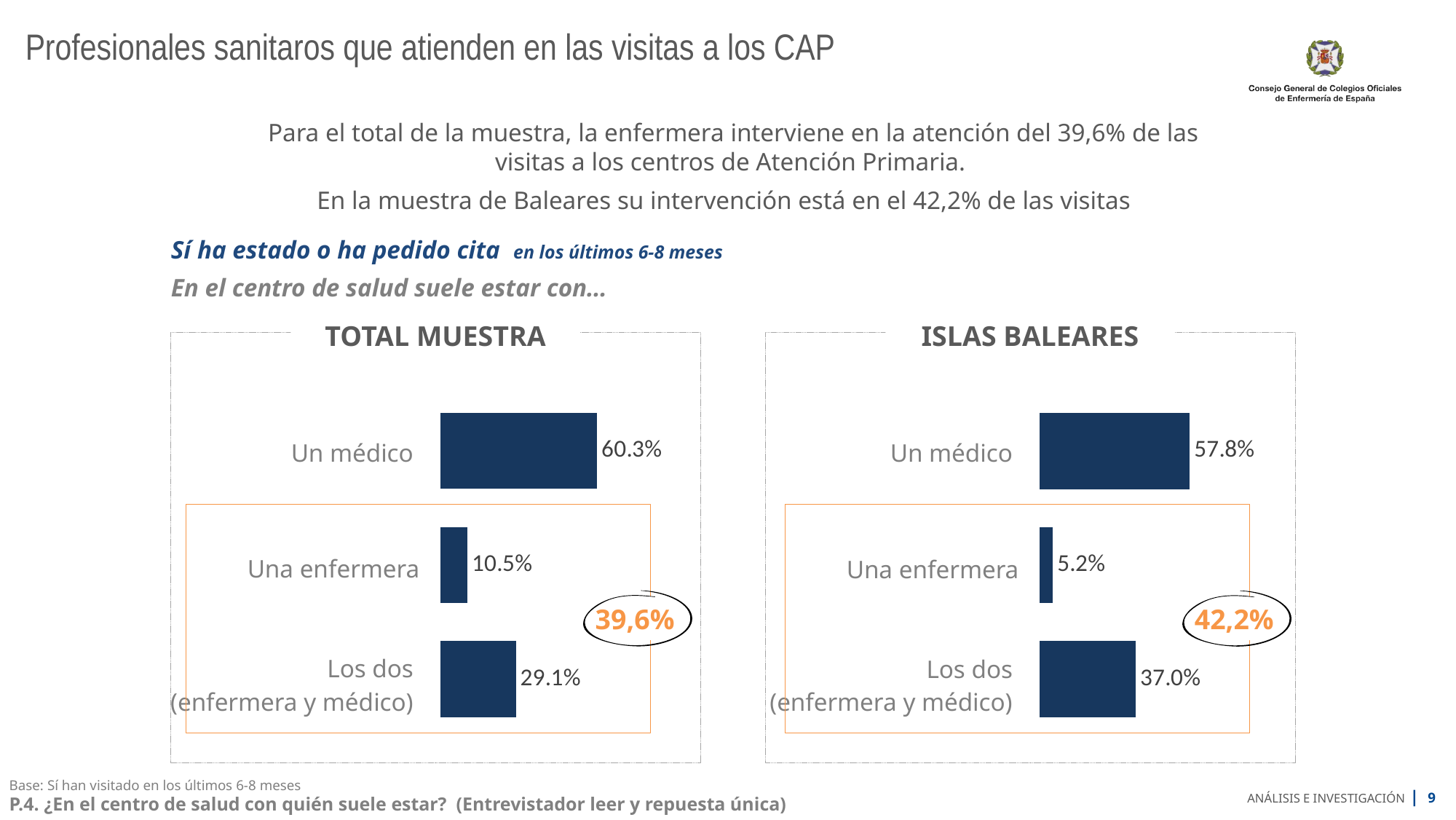
In the TOTAL MUESTRA chart, which category has the lowest value? Una enfermera In the ISLAS BALEARES chart, which category has the highest value? Un médico In the ISLAS BALEARES chart, what is the value for Una enfermera? 5.2% In the TOTAL MUESTRA chart, what is the difference between Un médico and Los dos (enfermera y médico)? 31.2% Which is larger: Los dos (enfermera y médico) in the TOTAL MUESTRA chart or Los dos (enfermera y médico) in the ISLAS BALEARES chart? ISLAS BALEARES In the TOTAL MUESTRA chart, what is the value for Un médico? 60.3% What percentage is highlighted in the orange circle on the ISLAS BALEARES chart? 42,2% In the TOTAL MUESTRA chart, what is the value for Una enfermera? 10.5% In the ISLAS BALEARES chart, what is the value for Los dos (enfermera y médico)? 37.0% What kind of chart is the ISLAS BALEARES chart? Bar chart How many categories does the TOTAL MUESTRA chart show? 3 In the ISLAS BALEARES chart, what is the difference between Un médico and Una enfermera? 52.6%